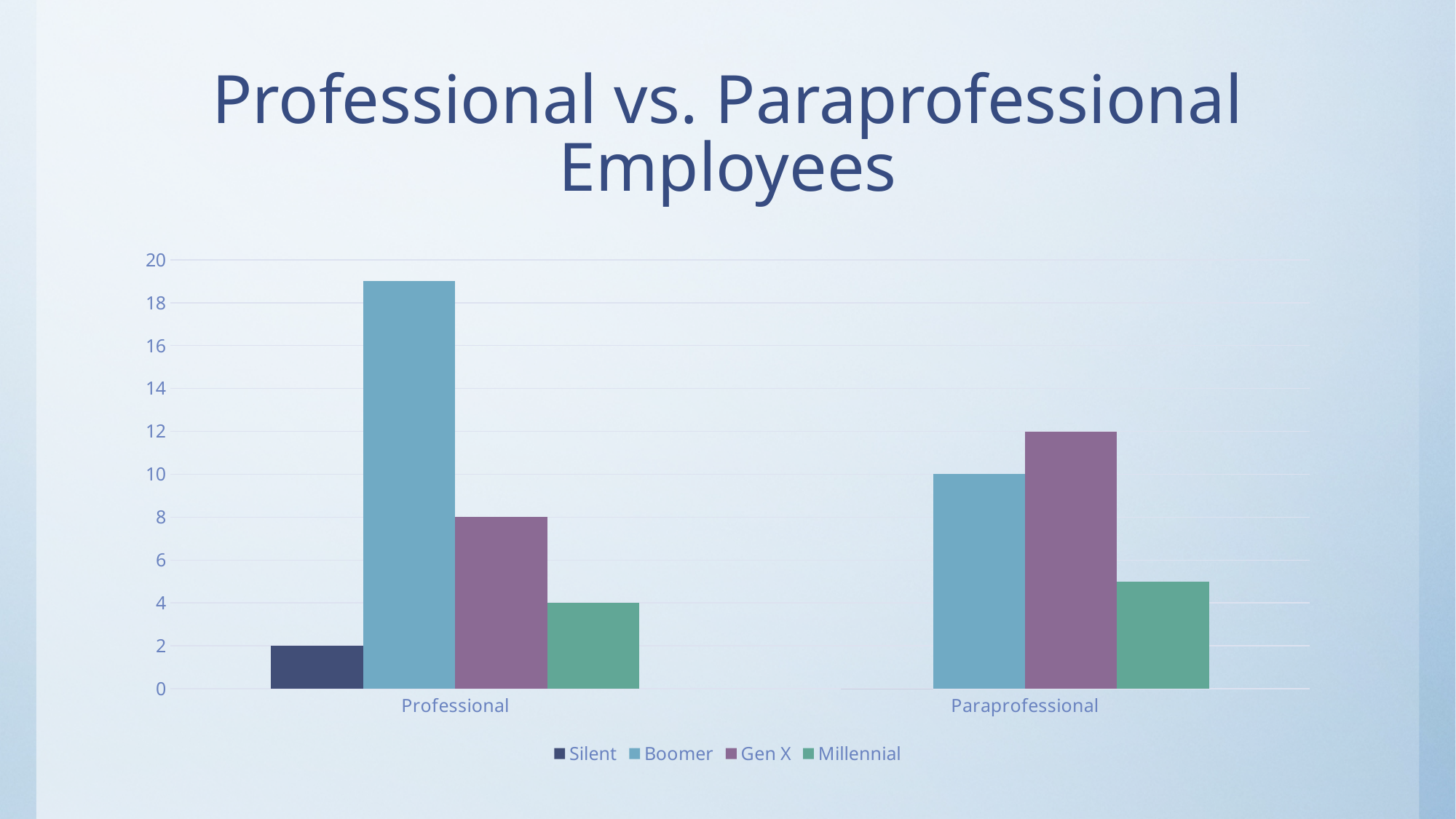
How many categories are shown on the x axis? 2 What kind of chart is shown on the slide? bar chart What is the value for Gen X in the Professional category? 8 Is the value for Boomer in the Professional category greater or less than 18? greater Which series has the highest value in the Paraprofessional category? Gen X Which series has the highest value in the Professional category? Boomer What is the value for Boomer in the Paraprofessional category? 10 What is the value for Millennial in the Professional category? 4 What is the value for Silent in the Professional category? 2 What is the difference between the Gen X and Silent values in the Professional category? 6 What is the value for Gen X in the Paraprofessional category? 12 How many series does the legend list? 4